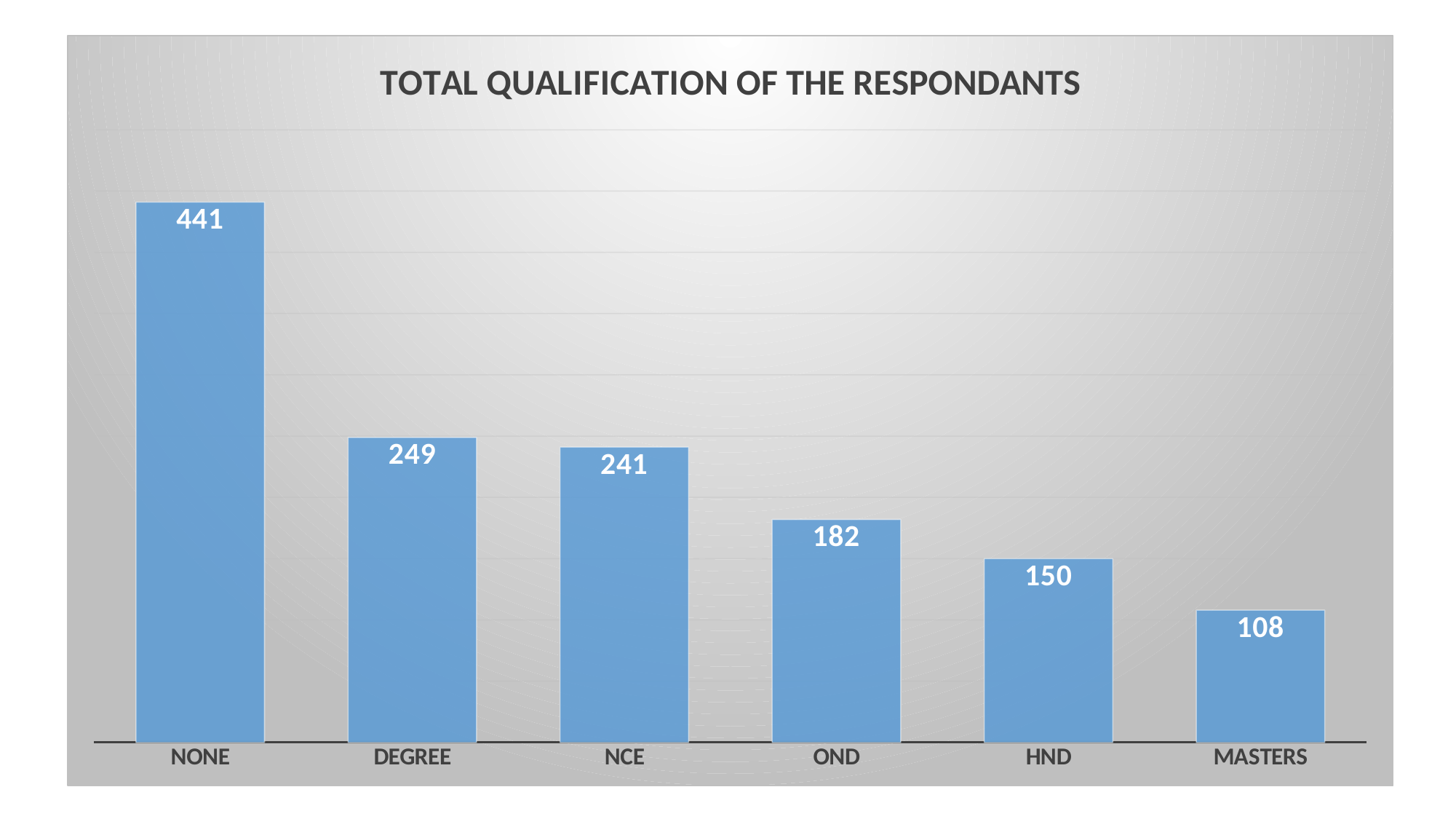
What is the value for OND? 182 What is the value for NONE? 441 What kind of chart is this? Bar chart Which is larger, the value for NCE or the value for OND? NCE What is the value for DEGREE? 249 Which category has the highest value? NONE Which category has the lowest value? MASTERS What is the value for MASTERS? 108 How many categories are shown on the x axis? 6 What is the difference between the values for NONE and DEGREE? 192 What is the title of the chart? TOTAL QUALIFICATION OF THE RESPONDANTS What is the difference between the values for HND and MASTERS? 42